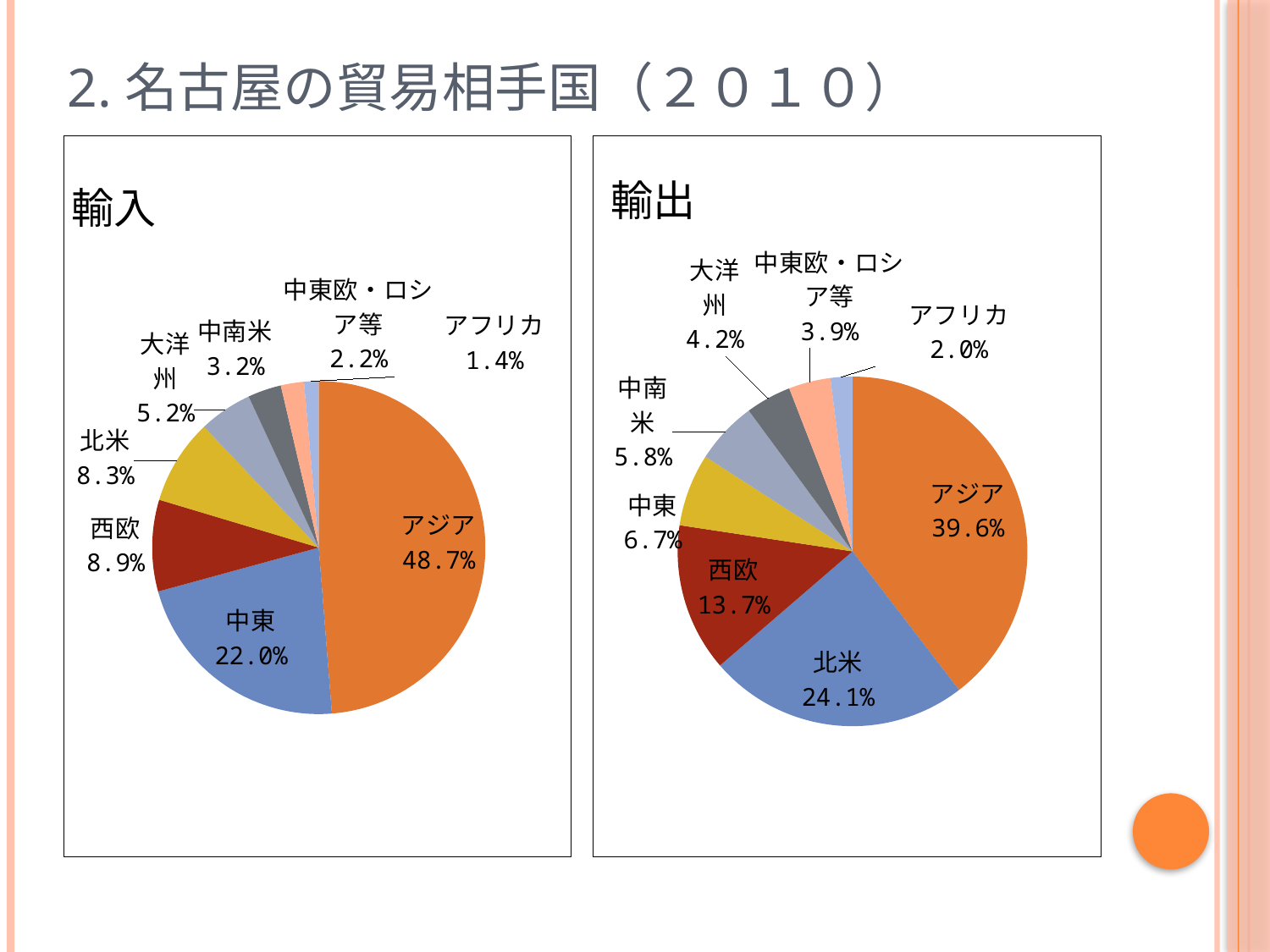
In the 輸出 pie chart, which region has the smallest share? アフリカ In the 輸入 (imports) pie chart, what share does アジア have? 48.7% What kind of chart is used for 輸出? Pie chart In the 輸入 pie chart, which region has the largest share? アジア In the 輸入 pie chart, which region has the smallest share? アフリカ In the 輸出 pie chart, what is the difference between the shares of アジア and 北米? 15.5% What is the title of the chart on the right? 輸出 How many slices does the 輸入 pie chart have? 8 In the 輸出 (exports) pie chart, what share does 北米 have? 24.1% In the 輸入 pie chart, what share does 中東 have? 22.0% In the 輸入 pie chart, which is larger, the share of 西欧 or the share of 北米? 西欧 In the 輸出 pie chart, which is larger, the share of 中東 or the share of 中南米? 中東